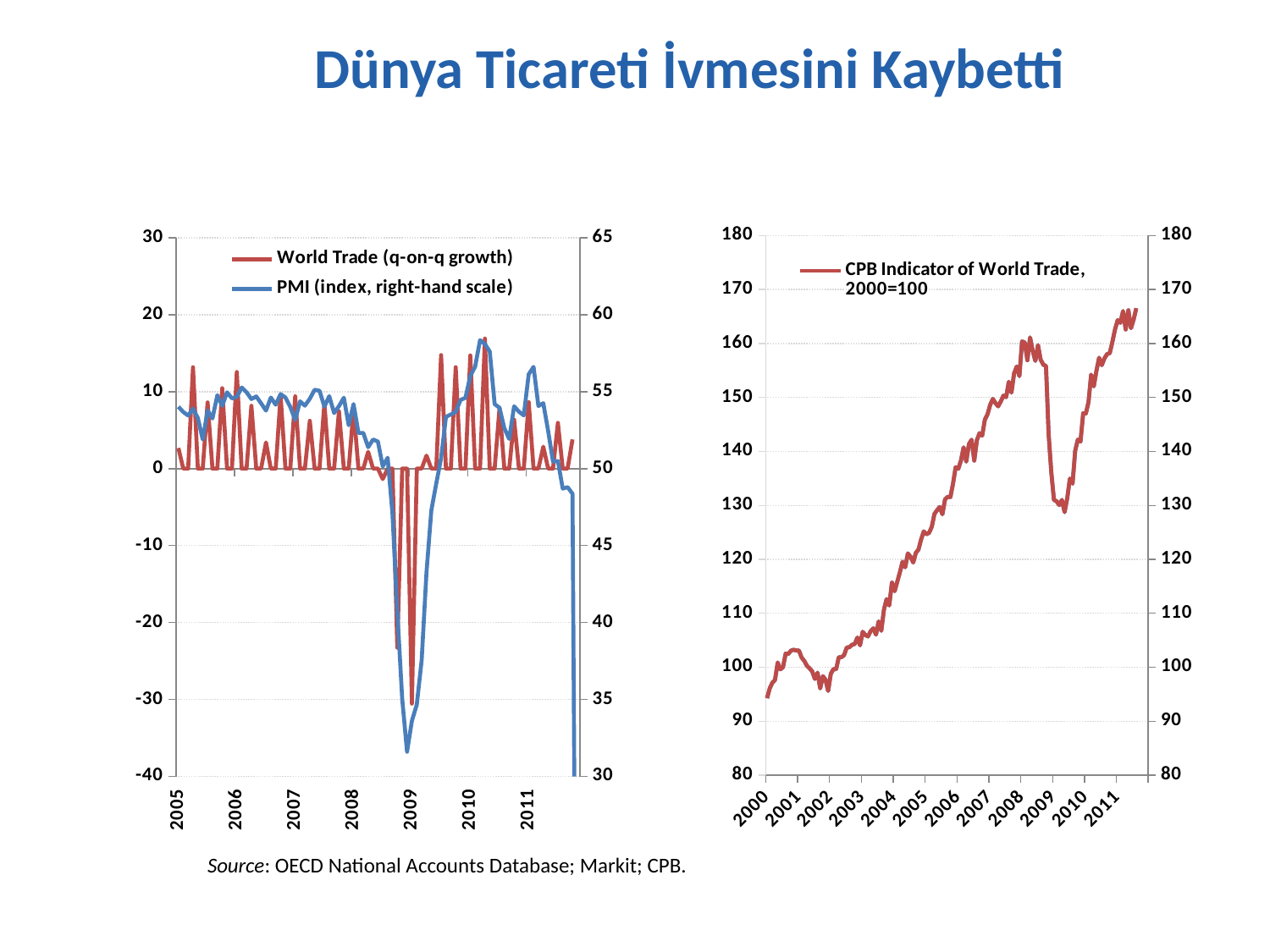
In the left chart, is the lowest value of the PMI index in 2009 greater or less than 35 on the right-hand scale? less In the right chart, is the CPB Indicator of World Trade at the start of 2000 greater or less than 100? less In the right chart, does the CPB Indicator of World Trade overall rise or fall from 2000 to 2011? rise How many series does the legend of the right chart list? 1 In the right chart, is the lowest value of the CPB Indicator of World Trade in 2009 greater or less than 140? less What kind of chart is the right chart showing the CPB Indicator of World Trade? line chart How many series does the legend of the left chart list? 2 In the left chart, which series is plotted against the right-hand scale? PMI (index, right-hand scale) What kind of chart is the left chart showing World Trade and PMI? line chart In the right chart, what base year is the CPB Indicator of World Trade indexed to, according to the legend? 2000=100